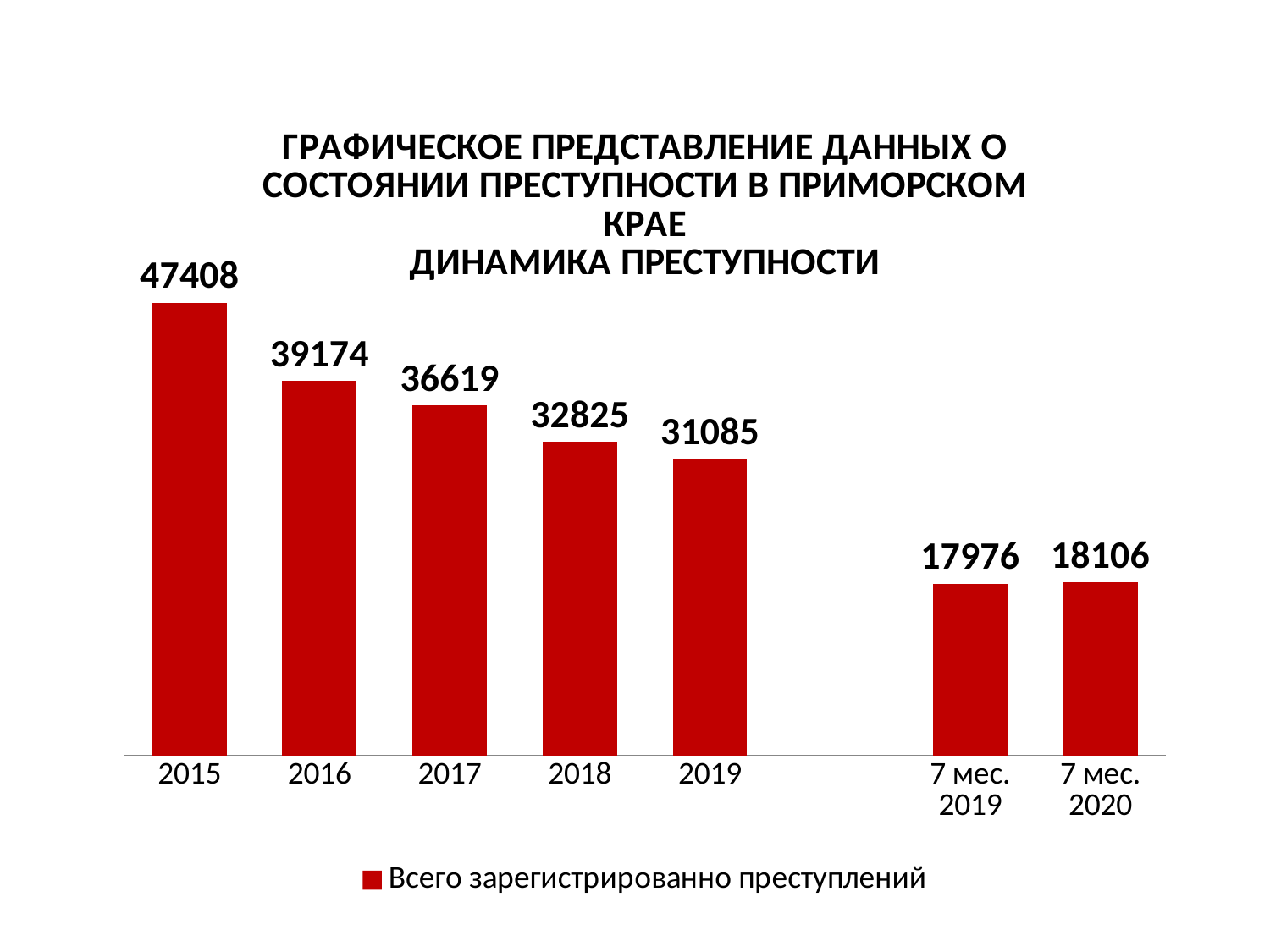
How many categories are shown on the x axis? 7 What is the value for 2018? 32825 What is the difference between the values for 7 мес. 2020 and 7 мес. 2019? 130 Do the values rise or fall from 2015 to 2019? fall What kind of chart is this? bar chart What is the value for 2015? 47408 How many series does the legend list? 1 What is the difference between the values for 2015 and 2019? 16323 What is the value for 7 мес. 2020? 18106 Which is larger, the value for 2016 or the value for 2017? 2016 Which category has the highest value? 2015 Which category has the lowest value? 7 мес. 2019